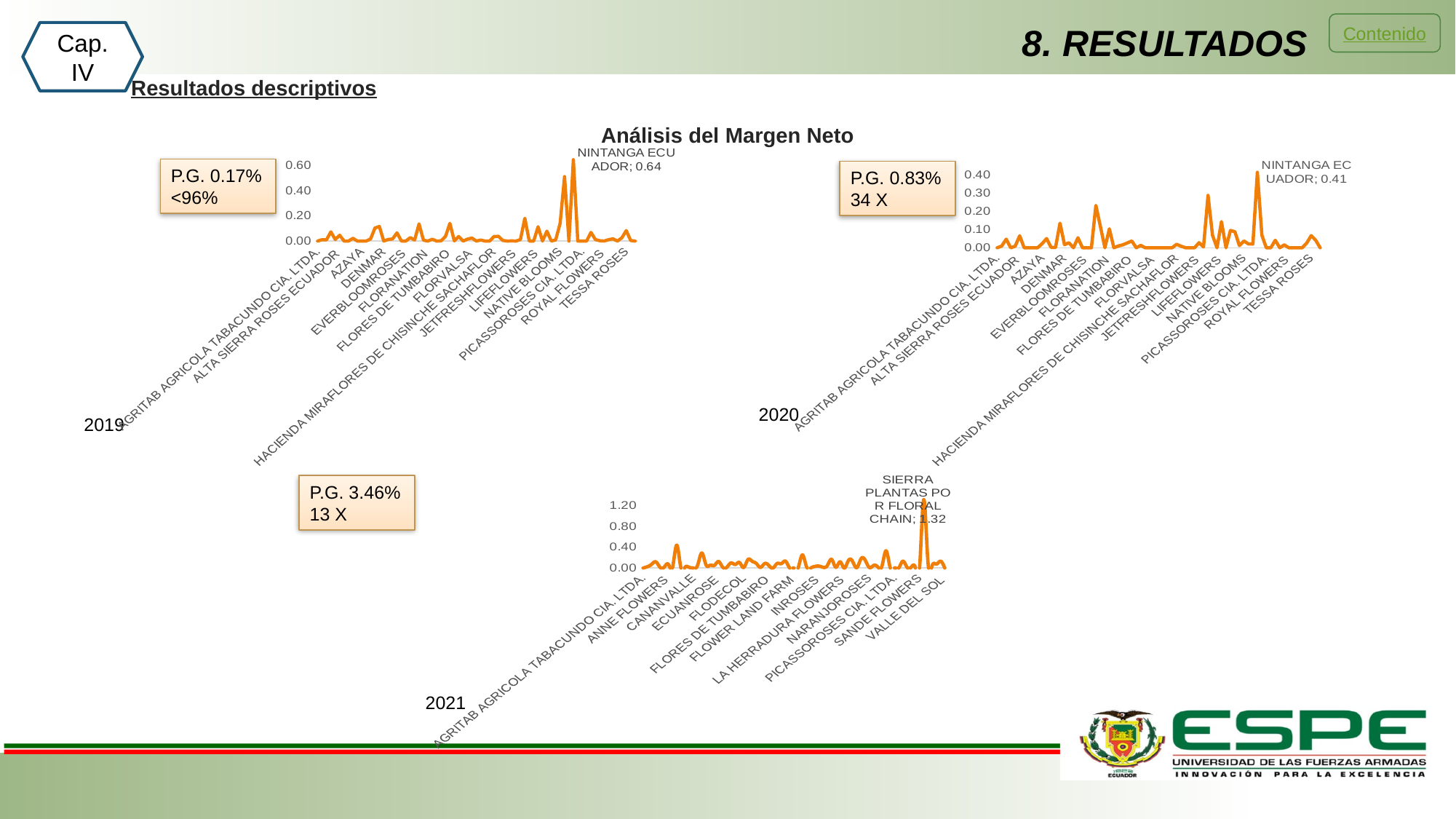
In the 2019 chart, which company has the highest net margin value? NINTANGA ECUADOR In the 2021 chart, is the value for SIERRA PLANTAS POR FLORAL CHAIN greater or less than 0.80? greater In the 2020 chart, which company has the highest net margin value? NINTANGA ECUADOR In the 2021 chart, what is the labelled value for SIERRA PLANTAS POR FLORAL CHAIN? 1.32 What is the overall title shown above the charts? Análisis del Margen Neto What is the difference between the labelled value for NINTANGA ECUADOR in the 2019 chart and in the 2020 chart? 0.23 What kind of chart is used for the 2019, 2020 and 2021 net margin analyses? Line chart How many line charts are shown on the slide? 3 In the 2021 chart, which company has the highest net margin value? SIERRA PLANTAS POR FLORAL CHAIN In the 2019 chart, what is the labelled value for NINTANGA ECUADOR? 0.64 In the 2020 chart, what is the labelled value for NINTANGA ECUADOR? 0.41 Which is larger: the labelled peak value in the 2019 chart (NINTANGA ECUADOR) or the labelled peak value in the 2021 chart (SIERRA PLANTAS POR FLORAL CHAIN)? The 2021 chart (SIERRA PLANTAS POR FLORAL CHAIN)